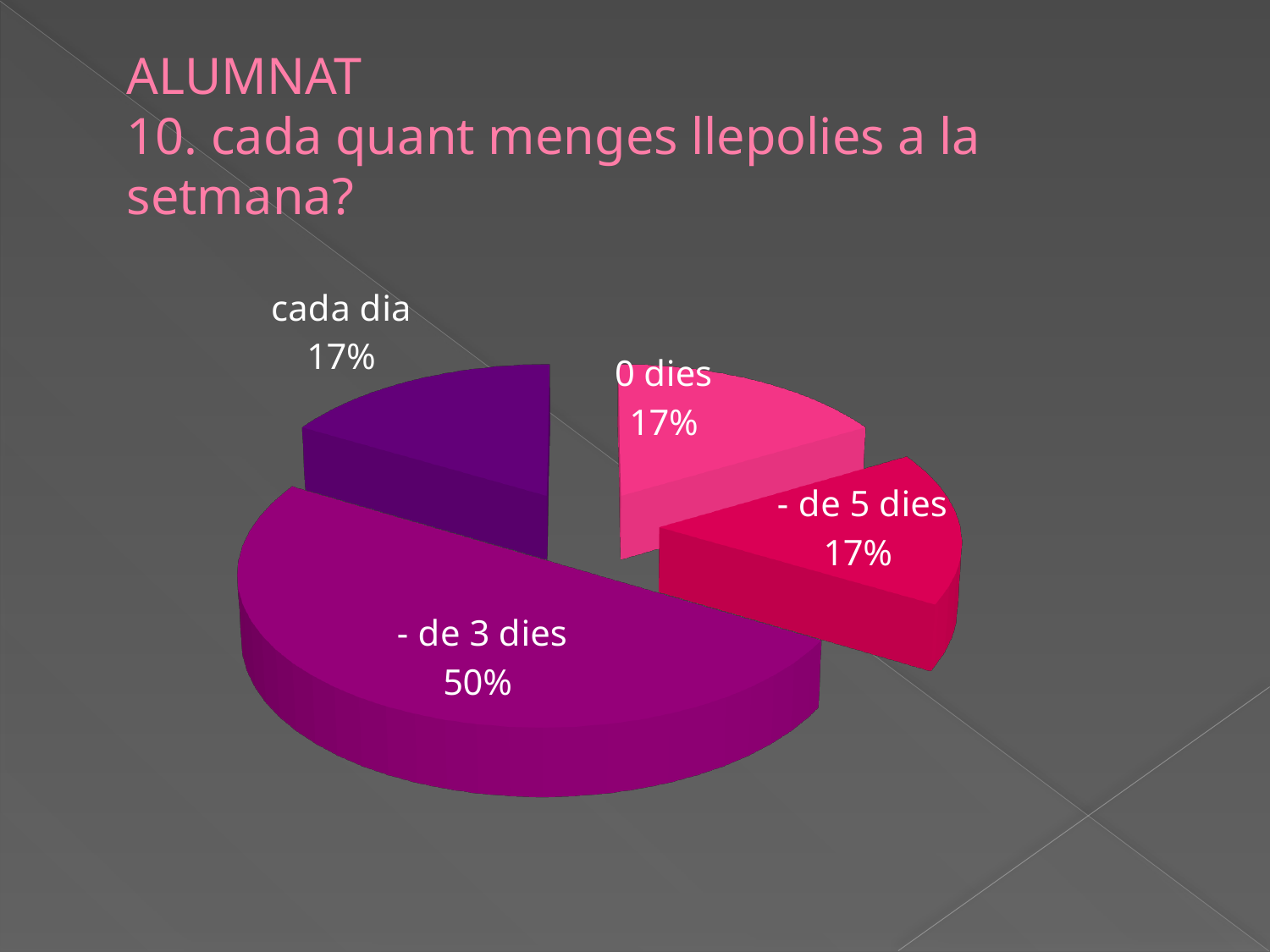
What share of the pie does "- de 3 dies" have? 50% What is the difference between the share for "- de 3 dies" and the share for "cada dia"? 33% Which is larger, the slice for "- de 3 dies" or the slice for "0 dies"? - de 3 dies What is the value shown for "0 dies"? 17% What kind of chart is shown on the slide? pie chart What is the value shown for "- de 5 dies"? 17% What question does the slide title say the chart answers? 10. cada quant menges llepolies a la setmana? What is the value shown for "cada dia"? 17% What is the combined share of "cada dia" and "0 dies"? 34% Which category has the largest slice of the pie? - de 3 dies How many slices does the pie chart have? 4 What colour is the "- de 3 dies" slice? purple/magenta